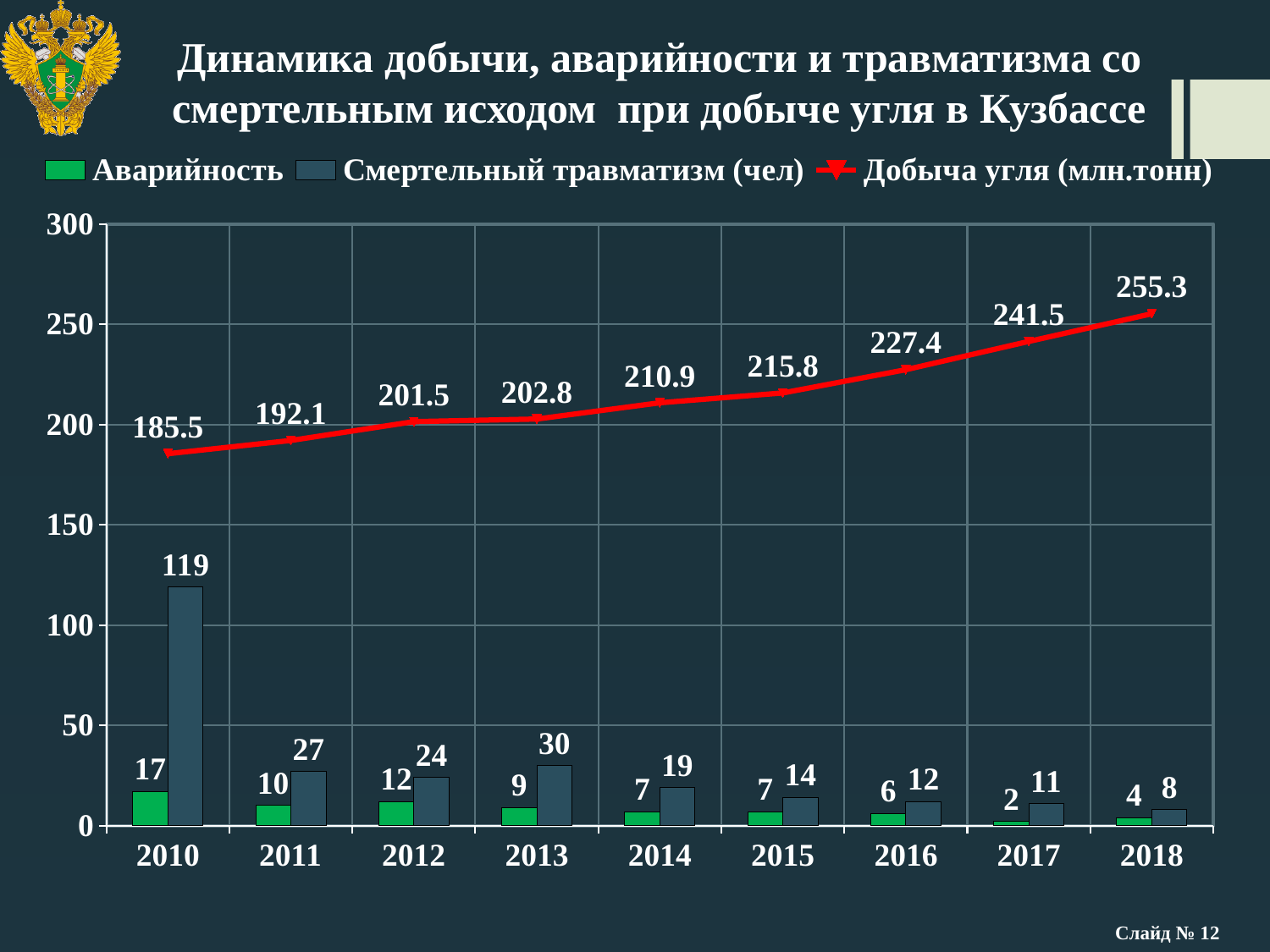
What is the value of Аварийность for 2013? 9 How many years are shown on the x axis? 9 In which year is Аварийность lowest? 2017 Which is larger: Смертельный травматизм (чел) in 2013 or in 2012? 2013 What is the value of Смертельный травматизм (чел) for 2010? 119 Is the value of Добыча угля (млн.тонн) for 2016 greater or less than 250? less How many series does the legend list? 3 Does Добыча угля (млн.тонн) rise or fall from 2010 to 2018? rise In which year is Смертельный травматизм (чел) highest? 2010 What is the value of Добыча угля (млн.тонн) for 2018? 255.3 What colour is the Аварийность series in the chart? green What is the difference between Добыча угля (млн.тонн) in 2018 and in 2010? 69.8